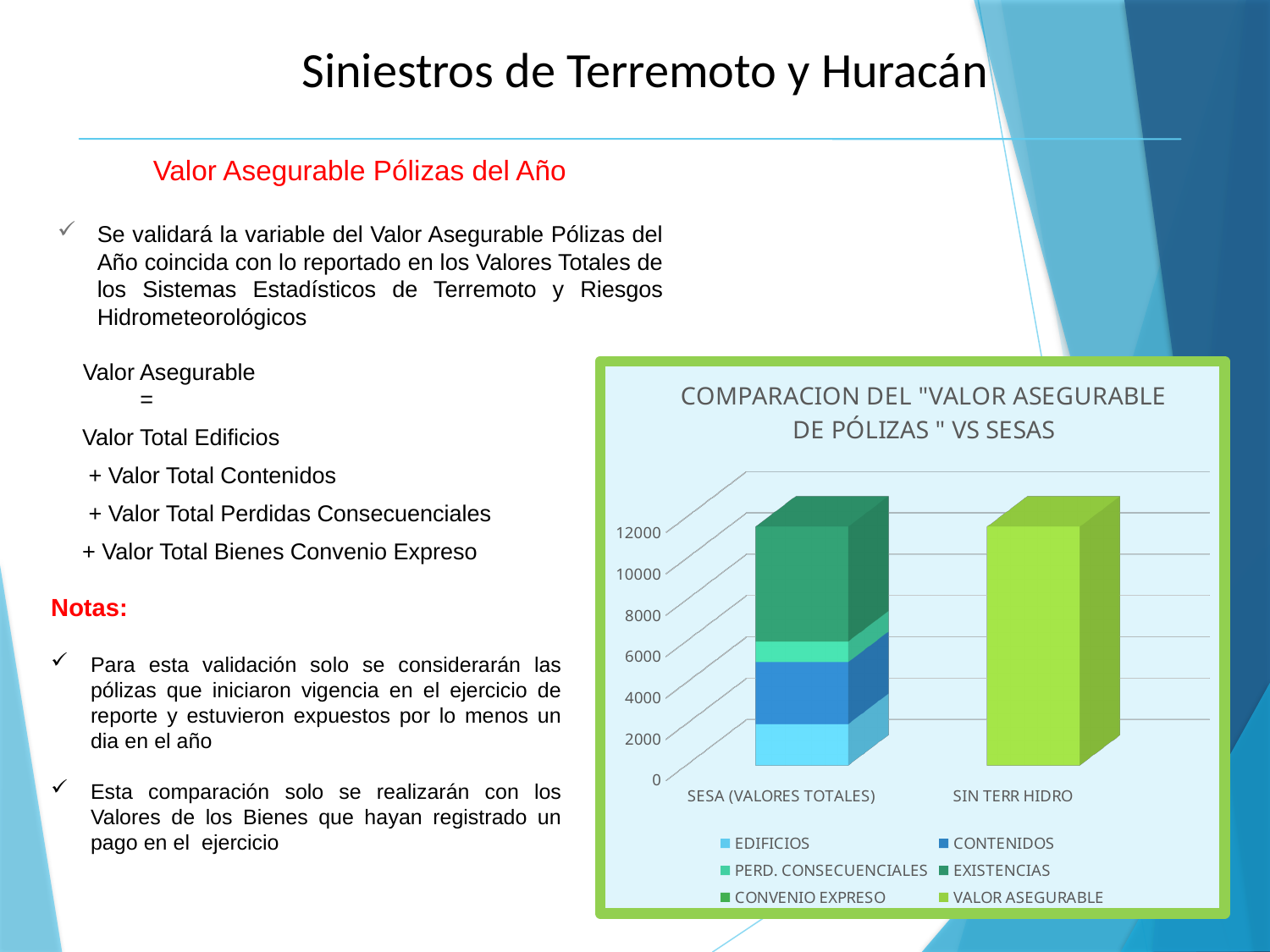
Is the EDIFICIOS segment of the SESA (VALORES TOTALES) bar greater or less than 4000? less Is the total height of the SESA (VALORES TOTALES) bar greater or less than 10000? greater Is the value for SIN TERR HIDRO greater or less than 10000? greater Which series makes up the entire SIN TERR HIDRO bar? VALOR ASEGURABLE How many categories are shown on the x axis of the chart? 2 Which segment is the largest in the SESA (VALORES TOTALES) bar? EXISTENCIAS Which segment is the smallest in the SESA (VALORES TOTALES) bar? PERD. CONSECUENCIALES How many series does the chart legend list? 6 In the SESA (VALORES TOTALES) bar, which segment is larger: EXISTENCIAS or CONTENIDOS? EXISTENCIAS What kind of chart is shown on the slide? Stacked bar chart What is the title of the chart? COMPARACION DEL "VALOR ASEGURABLE DE PÓLIZAS " VS SESAS